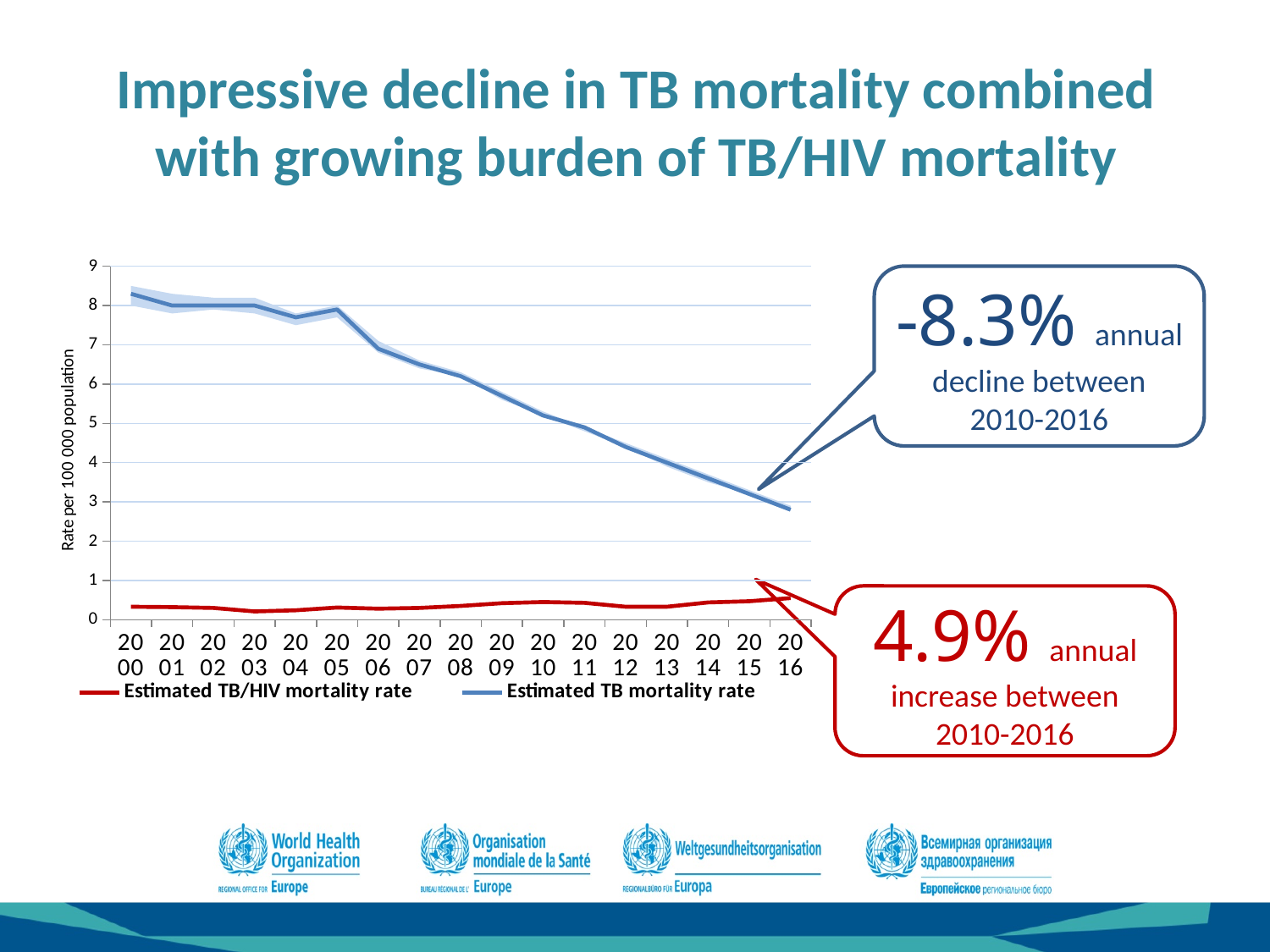
Is the Estimated TB/HIV mortality rate in 2016 greater or less than 1? less Is the Estimated TB mortality rate in 2016 greater or less than 4? less In 2008, which is larger: the Estimated TB mortality rate or the Estimated TB/HIV mortality rate? Estimated TB mortality rate In which year is the Estimated TB mortality rate highest? 2000 Does the Estimated TB mortality rate rise or fall from 2000 to 2016? Fall What kind of chart is shown on the slide? Line chart Does the Estimated TB/HIV mortality rate rise or fall overall from 2000 to 2016? Rise Is the Estimated TB mortality rate in 2000 greater or less than 7? greater In which year is the Estimated TB mortality rate lowest? 2016 How many series does the chart legend list? 2 How many years are plotted along the x axis of the chart? 17 What is the label of the chart's y axis? Rate per 100 000 population